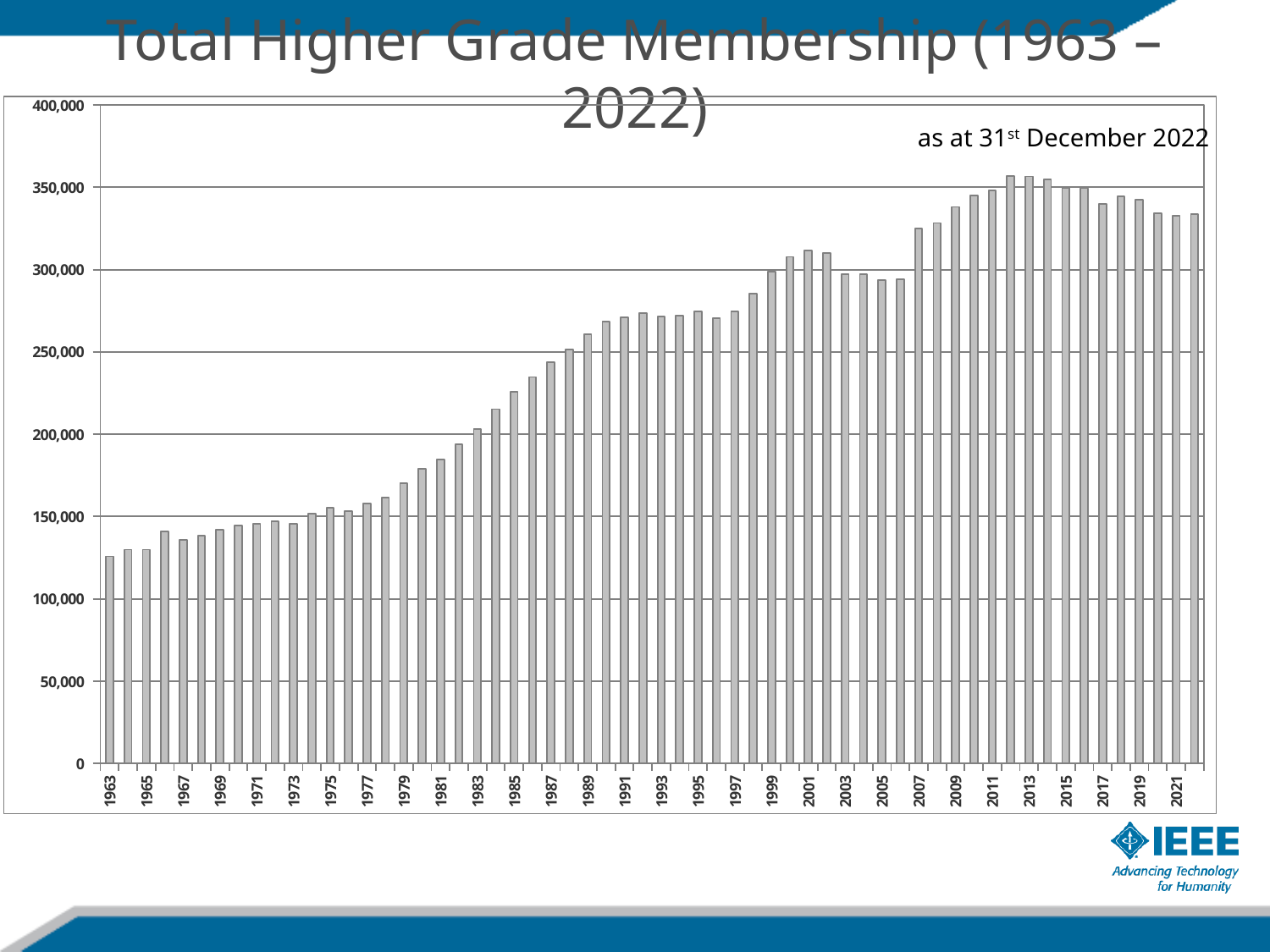
Which year has the larger membership, 1991 or 2001? 2001 Which year has the lowest Total Higher Grade Membership? 1963 As at what date is the membership data reported, according to the note on the chart? 31st December 2022 Is the value for 1997 greater or less than 300,000? less How many years (bars) are plotted in the chart? 60 Is the value for 1983 greater or less than 200,000? greater What is the title of the chart? Total Higher Grade Membership (1963 – 2022) Is the value for 1963 greater or less than 150,000? less Does membership generally rise or fall from 1963 to 2013? rise What kind of chart is shown on the slide? bar chart